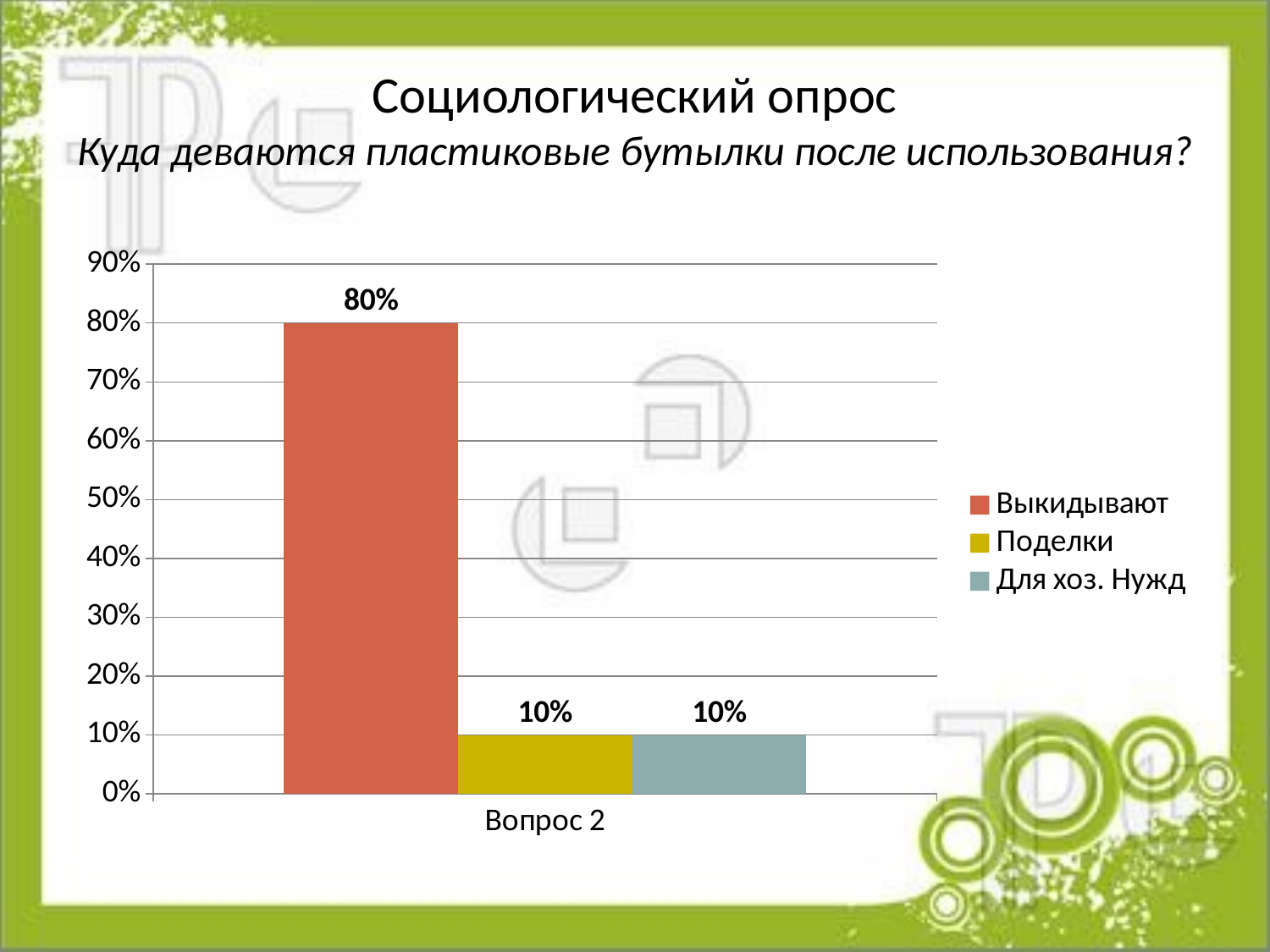
What is the value for Для хоз. Нужд? 10% Which is larger, the value for Выкидывают or the value for Для хоз. Нужд? Выкидывают Which series has the highest value? Выкидывают What is the difference between the values for Выкидывают and Поделки? 70% What is the value for Поделки? 10% Is the value for Выкидывают greater or less than 50%? greater Is the value for Поделки greater or less than 20%? less What kind of chart is shown on the slide? bar chart How many series does the legend list? 3 What is the value for Выкидывают? 80% What is the category label on the x axis? Вопрос 2 What colour is the bar for Выкидывают? red